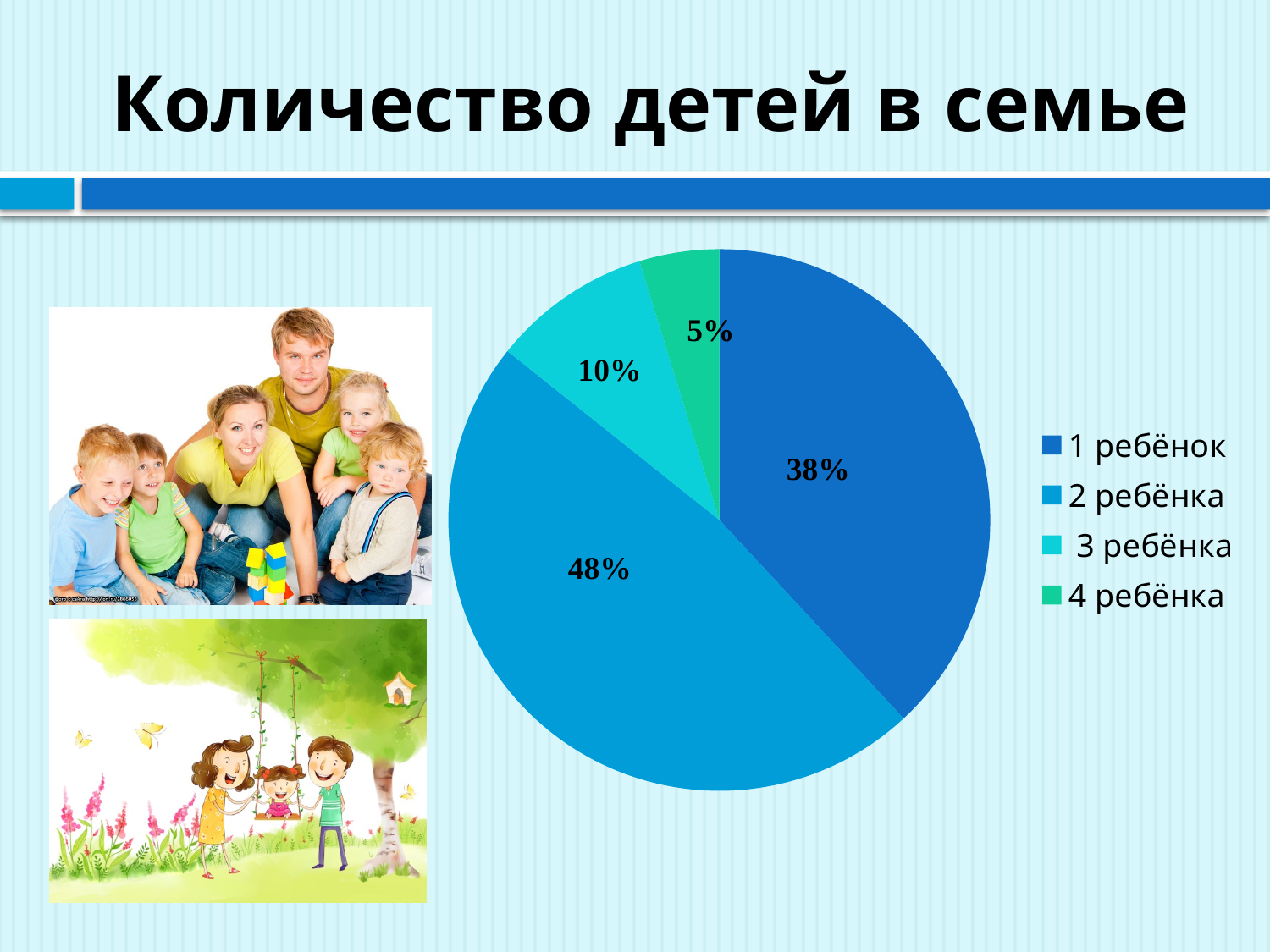
Which slice is larger: '3 ребёнка' or '4 ребёнка'? 3 ребёнка Which category has the smallest slice of the pie chart? 4 ребёнка What share of the pie chart is labelled for '4 ребёнка'? 5% What is the difference in percentage points between the '2 ребёнка' slice and the '1 ребёнок' slice? 10 What kind of chart is shown on the slide? Pie chart How many slices does the pie chart have? 4 What is the title of the slide containing the chart? Количество детей в семье What share of the pie chart is labelled for '2 ребёнка'? 48% Which category has the largest slice of the pie chart? 2 ребёнка What share of the pie chart is labelled for '1 ребёнок'? 38% How many entries does the legend list? 4 What share of the pie chart is labelled for '3 ребёнка'? 10%